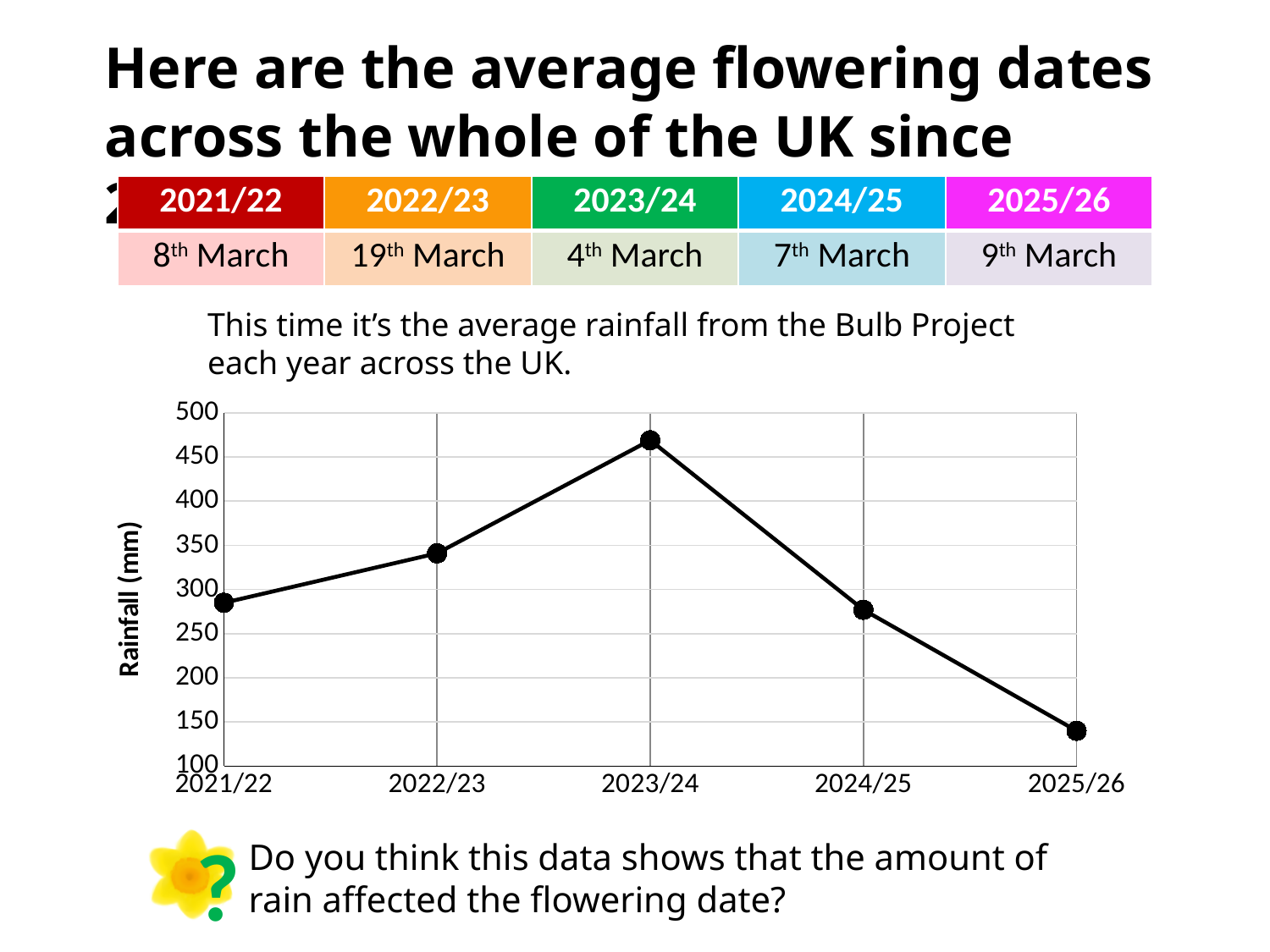
Which year has the highest average rainfall on the chart? 2023/24 How many years are plotted on the rainfall chart? 5 Which year has the lowest average rainfall on the chart? 2025/26 What is the label on the vertical axis of the chart? Rainfall (mm) Is the rainfall value for 2023/24 greater or less than 400? greater Is the rainfall value for 2024/25 greater or less than 300? less What kind of chart is shown on the slide? line chart Is the rainfall value for 2025/26 greater or less than 200? less Does the rainfall rise or fall from 2021/22 to 2023/24? rise Does the rainfall rise or fall from 2023/24 to 2025/26? fall Which year has higher rainfall, 2022/23 or 2024/25? 2022/23